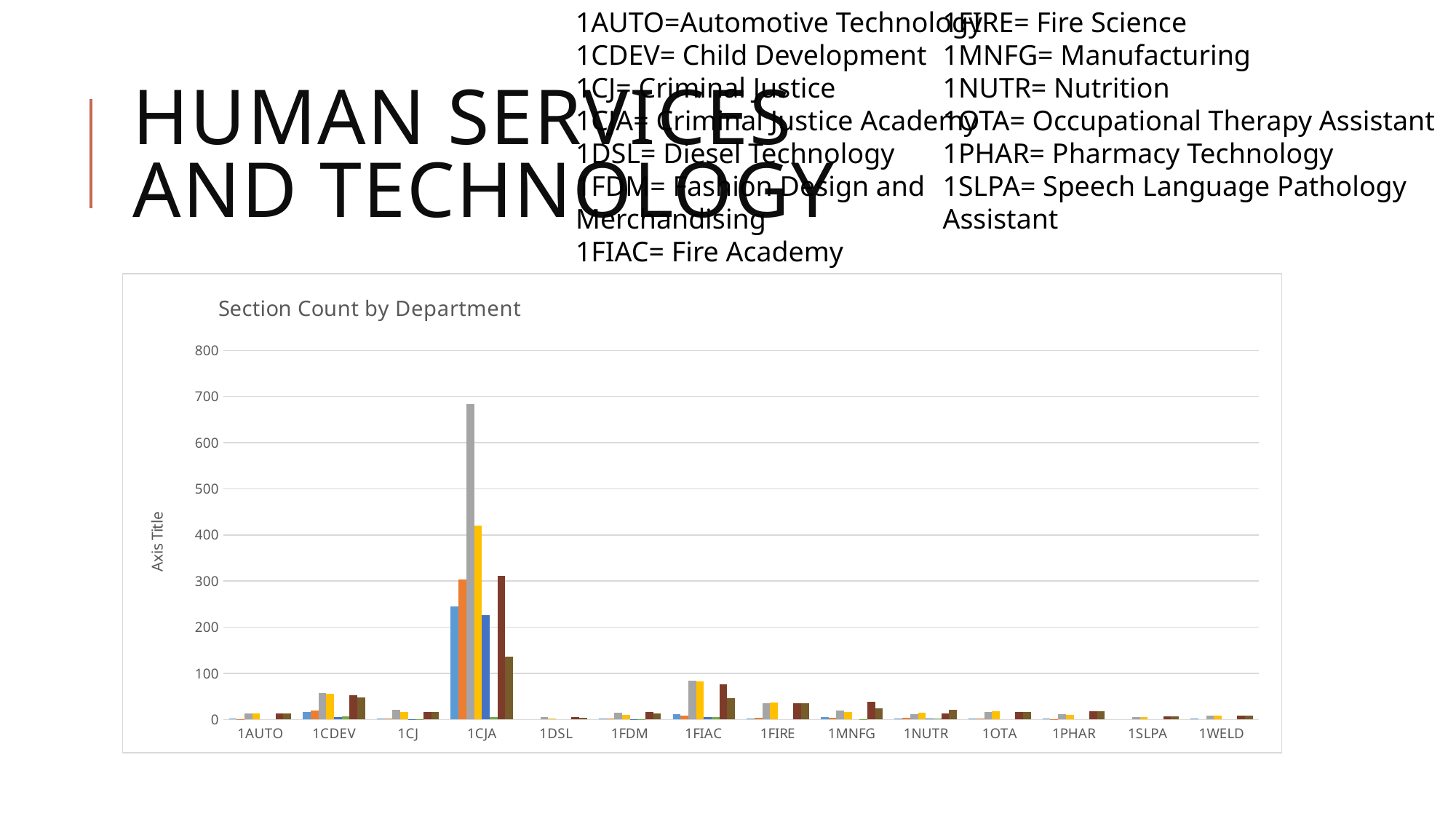
What is the label of the last department on the x axis? 1WELD Which department has taller bars overall, 1CJA or 1FIAC? 1CJA How many departments are shown along the x axis of the chart? 14 Which department has taller bars overall, 1FIAC or 1DSL? 1FIAC What is the title of the chart? Section Count by Department Is the tallest bar for 1CJA greater or less than 600? greater What is the label of the first department on the x axis? 1AUTO Which department has the tallest bar in the chart? 1CJA Is the tallest bar for 1CDEV greater or less than 100? less What kind of chart is shown on the slide? bar chart What is the highest value shown on the vertical axis? 800 Is the tallest bar for 1FIAC greater or less than 100? less